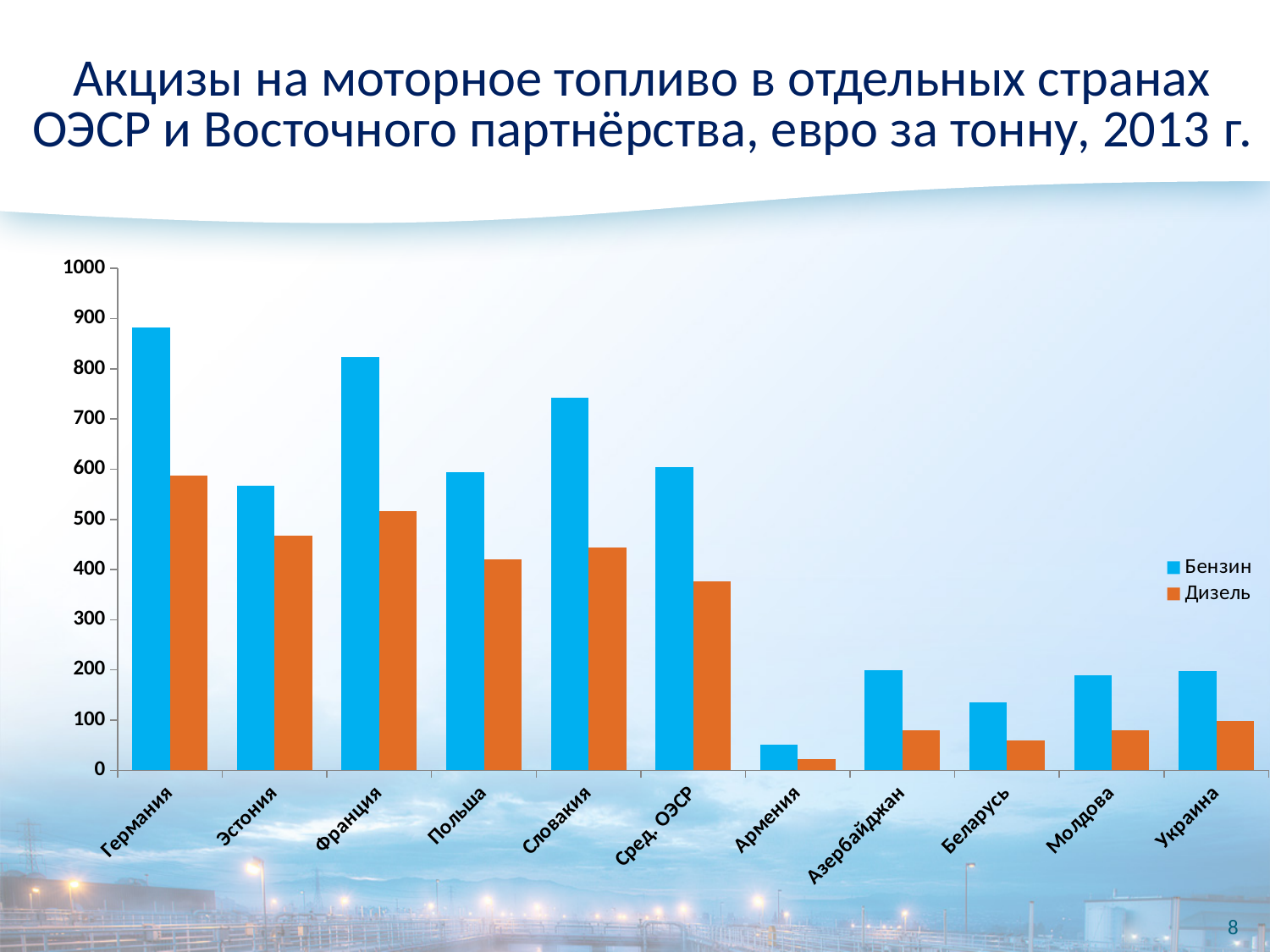
Which series is shown in orange in the legend? Дизель Which category has the highest value for Бензин? Германия How many series does the legend list? 2 What kind of chart is shown on the slide? bar chart Is the Бензин value for Германия greater or less than 800? greater Is the Дизель value for Сред. ОЭСР greater or less than 400? less Which category has the lowest value for Дизель? Армения Is the Бензин value for Словакия greater or less than 700? greater Which is larger, the Бензин value for Словакия or the Бензин value for Сред. ОЭСР? Словакия Which category has the lowest value for Бензин? Армения Which category has the highest value for Дизель? Германия How many countries/categories are shown on the x axis? 11